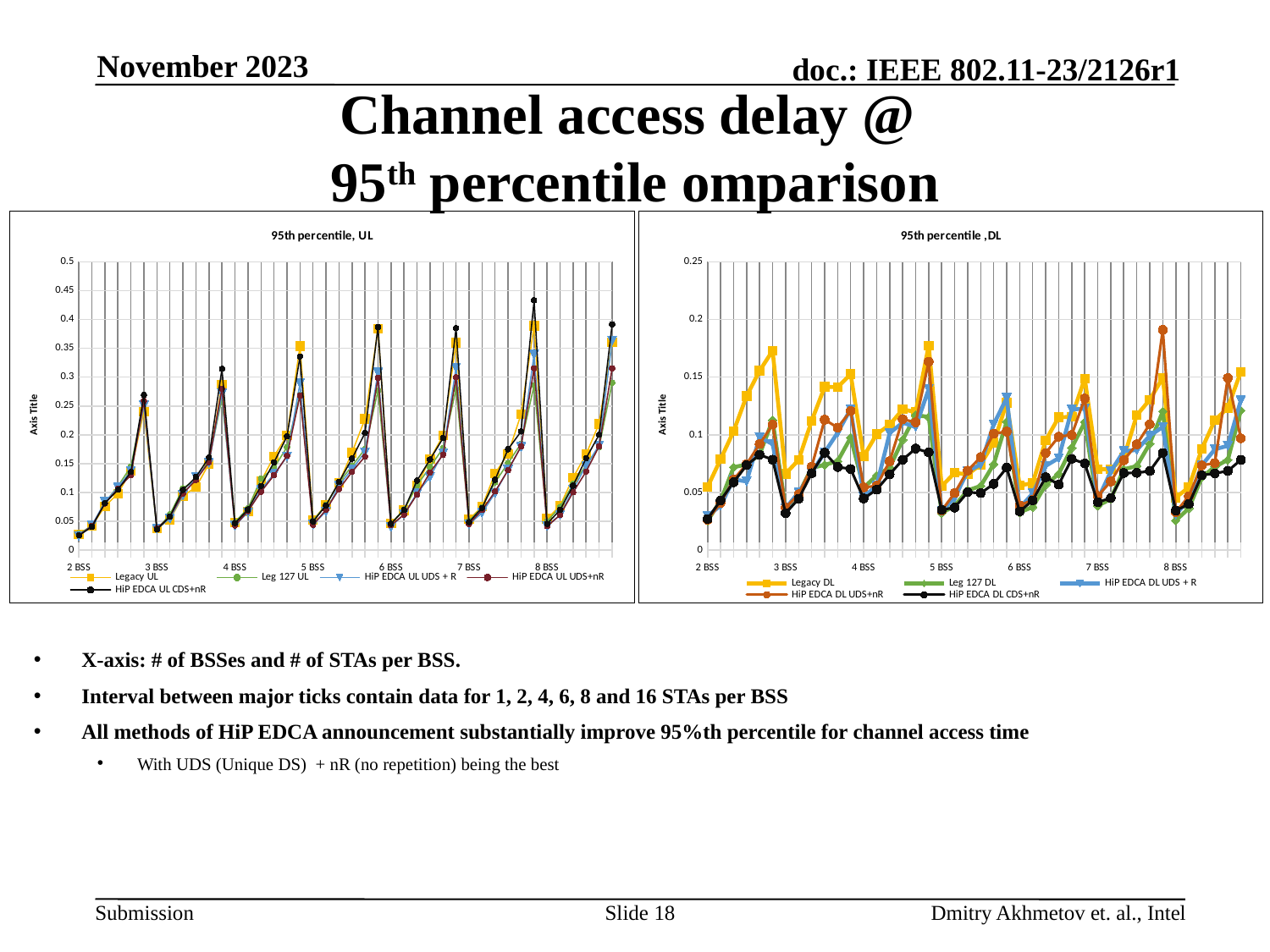
How many series does the legend of the '95th percentile ,DL' chart list? 5 In the '95th percentile ,DL' chart, is the highest value reached by HiP EDCA DL CDS+nR greater or less than 0.1? less In the '95th percentile, UL' chart, do the values rise or fall within each BSS group as the number of STAs per BSS increases? rise How many BSS categories are labelled on the x-axis of the '95th percentile, UL' chart? 7 How many series does the legend of the '95th percentile, UL' chart list? 5 What is the title of the left chart on the slide? 95th percentile, UL In the '95th percentile, UL' chart, which series reaches the highest value on the chart? HiP EDCA UL CDS+nR What kind of chart is the '95th percentile, UL' chart? line chart In the '95th percentile ,DL' chart, which series reaches the highest value on the chart? HiP EDCA DL UDS+nR What kind of chart is the '95th percentile ,DL' chart? line chart